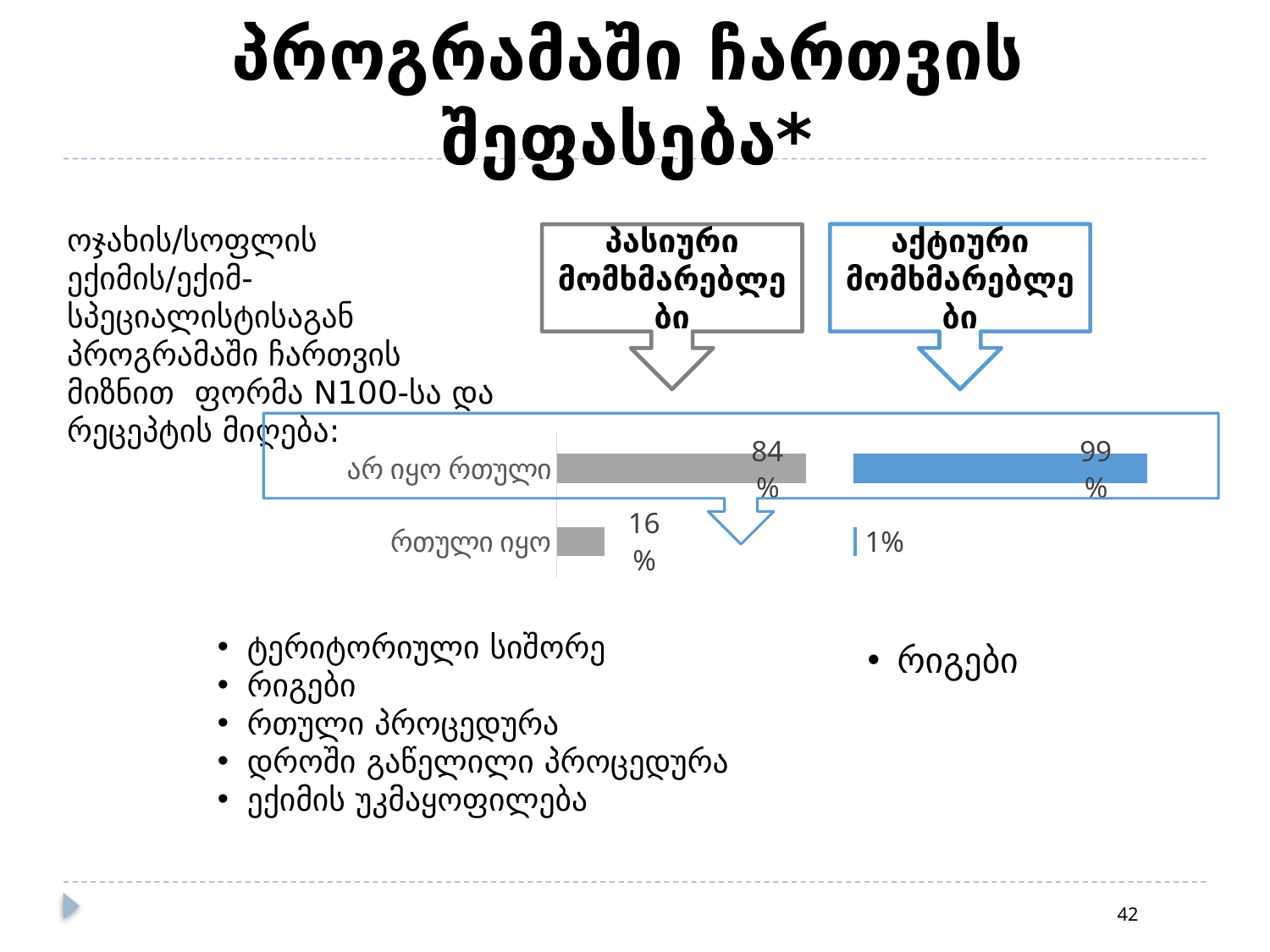
What colour are the bars for აქტიური მომხმარებლები? blue What is the difference between the "არ იყო რთული" values for the blue and gray series? 15% For "რთული იყო", which series has the larger value, gray (პასიური) or blue (აქტიური)? gray (პასიური მომხმარებლები) How many categories are shown on the chart? 2 What kind of chart is shown on the slide? bar chart What is the value for "რთული იყო" for the blue (აქტიური მომხმარებლები) series? 1% What is the value for "არ იყო რთული" for the gray (პასიური მომხმარებლები) series? 84% What is the value for "რთული იყო" for the gray (პასიური მომხმარებლები) series? 16% What is the value for "არ იყო რთული" for the blue (აქტიური მომხმარებლები) series? 99% What is the difference between the "რთული იყო" values for the gray and blue series? 15% Which category has the lowest value in the blue (აქტიური მომხმარებლები) series? რთული იყო Which category has the highest value in the gray (პასიური მომხმარებლები) series? არ იყო რთული